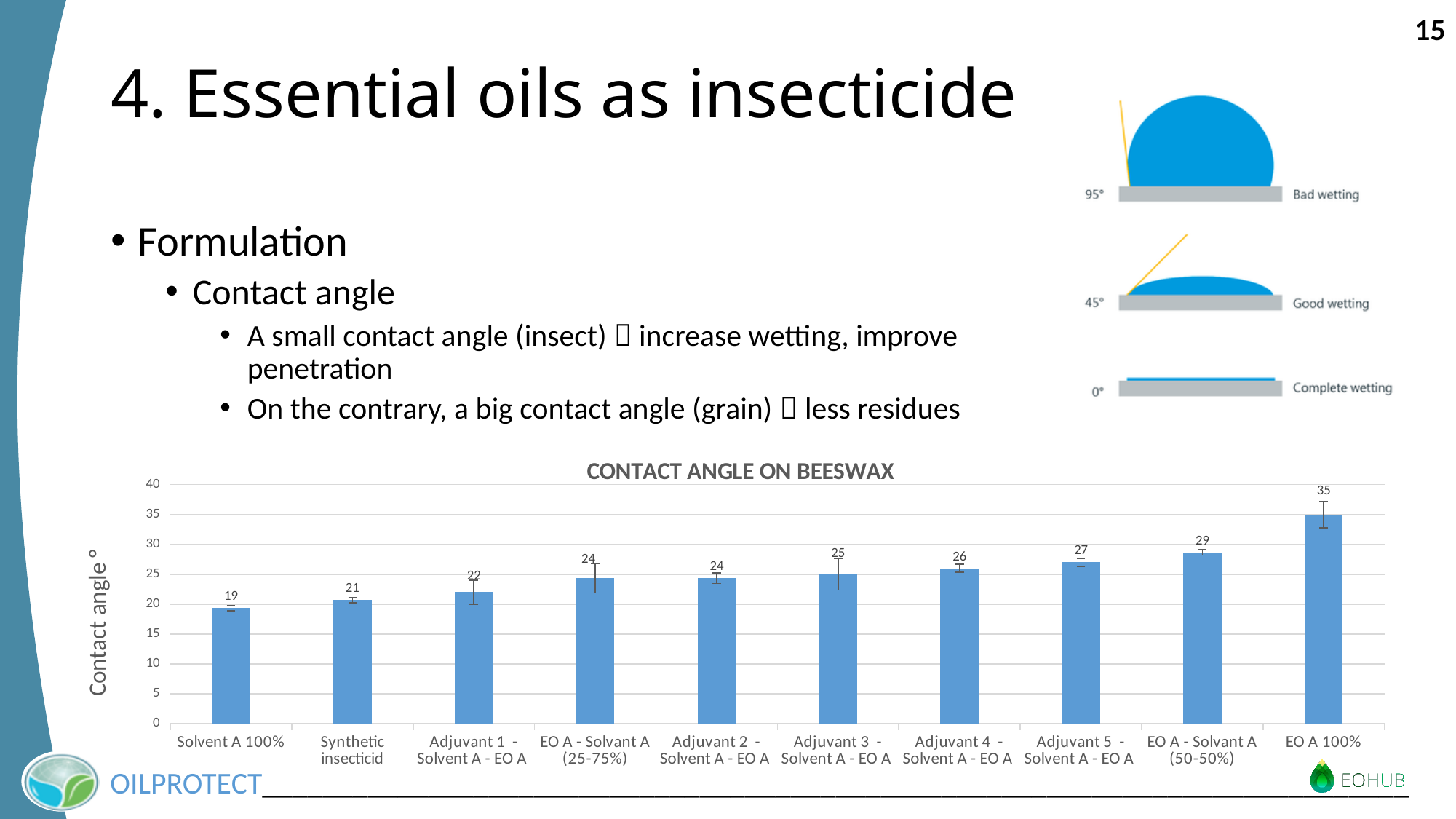
Is the value for EO A - Solvant A (25-75%) greater or less than 20? greater What is the difference between the contact angle for EO A 100% and Solvent A 100%? 16 Which category has the lowest contact angle? Solvent A 100% What is the contact angle value for EO A 100%? 35 What is the contact angle value for EO A - Solvant A (50-50%)? 29 Which category has the highest contact angle? EO A 100% Which has a larger contact angle, Synthetic insecticid or Adjuvant 5 - Solvent A - EO A? Adjuvant 5 - Solvent A - EO A What is the title of the chart? CONTACT ANGLE ON BEESWAX What is the contact angle value for Solvent A 100%? 19 How many categories are shown on the x axis of the chart? 10 What is the contact angle value for Adjuvant 3 - Solvent A - EO A? 25 What kind of chart is shown on the slide? bar chart